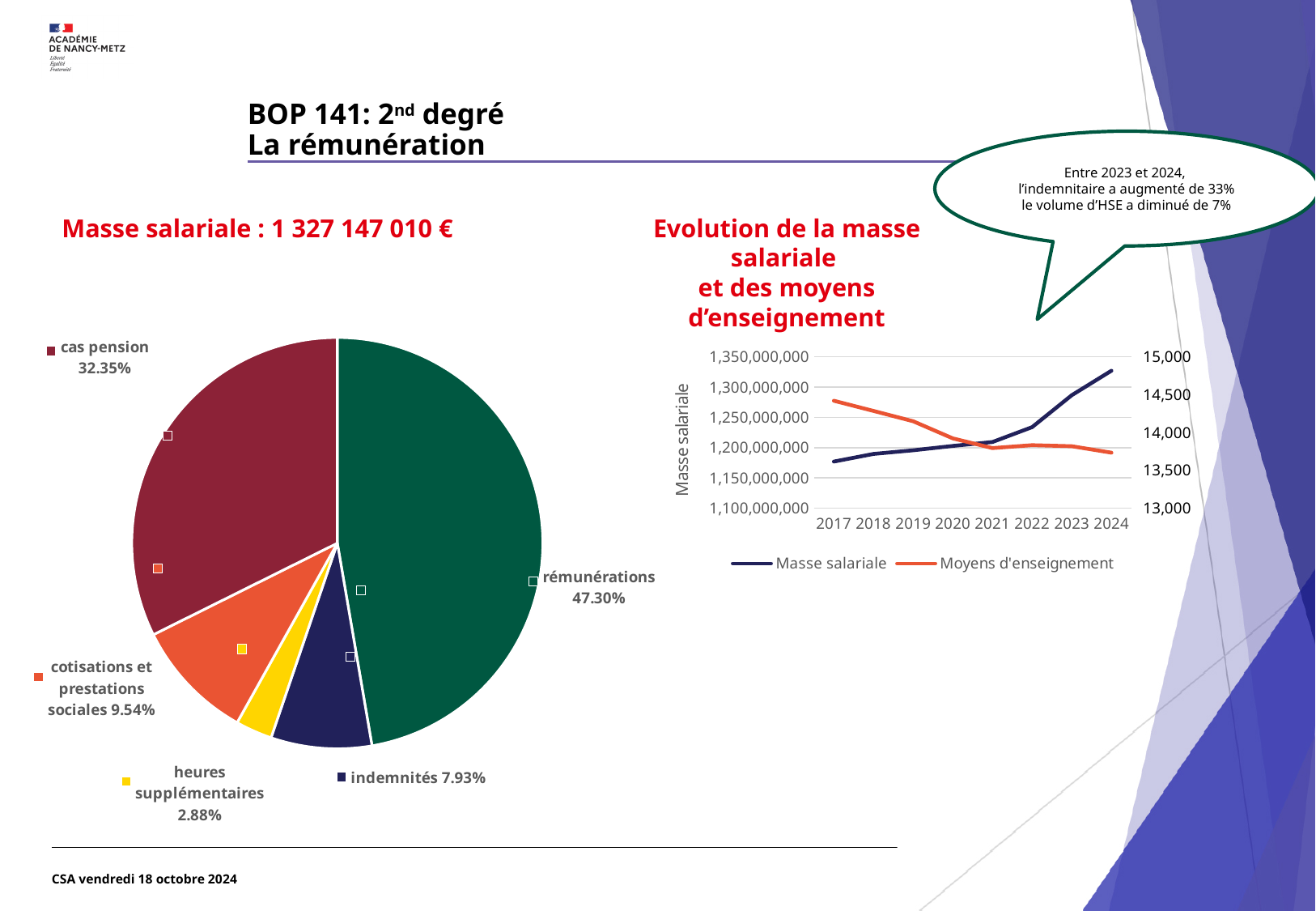
On the pie chart, what share does cas pension represent? 32.35% How many series does the legend of the 'Evolution de la masse salariale et des moyens d'enseignement' chart list? 2 On the 'Evolution de la masse salariale et des moyens d'enseignement' chart, does the Masse salariale series rise or fall from 2017 to 2024? rise On the pie chart, what is the difference in percentage points between cas pension and indemnités? 24.42 On the pie chart, what share does rémunérations represent? 47.30% On the pie chart, which category has the smallest share? heures supplémentaires On the pie chart, which category has the largest share? rémunérations How many slices does the pie chart have? 5 On the pie chart, which is larger: cotisations et prestations sociales or indemnités? cotisations et prestations sociales What type of chart is the 'Evolution de la masse salariale et des moyens d'enseignement' chart? line chart On the 'Evolution de la masse salariale et des moyens d'enseignement' chart, is the Masse salariale value for 2024 greater or less than 1,300,000,000? greater On the pie chart, what share do heures supplémentaires represent? 2.88%